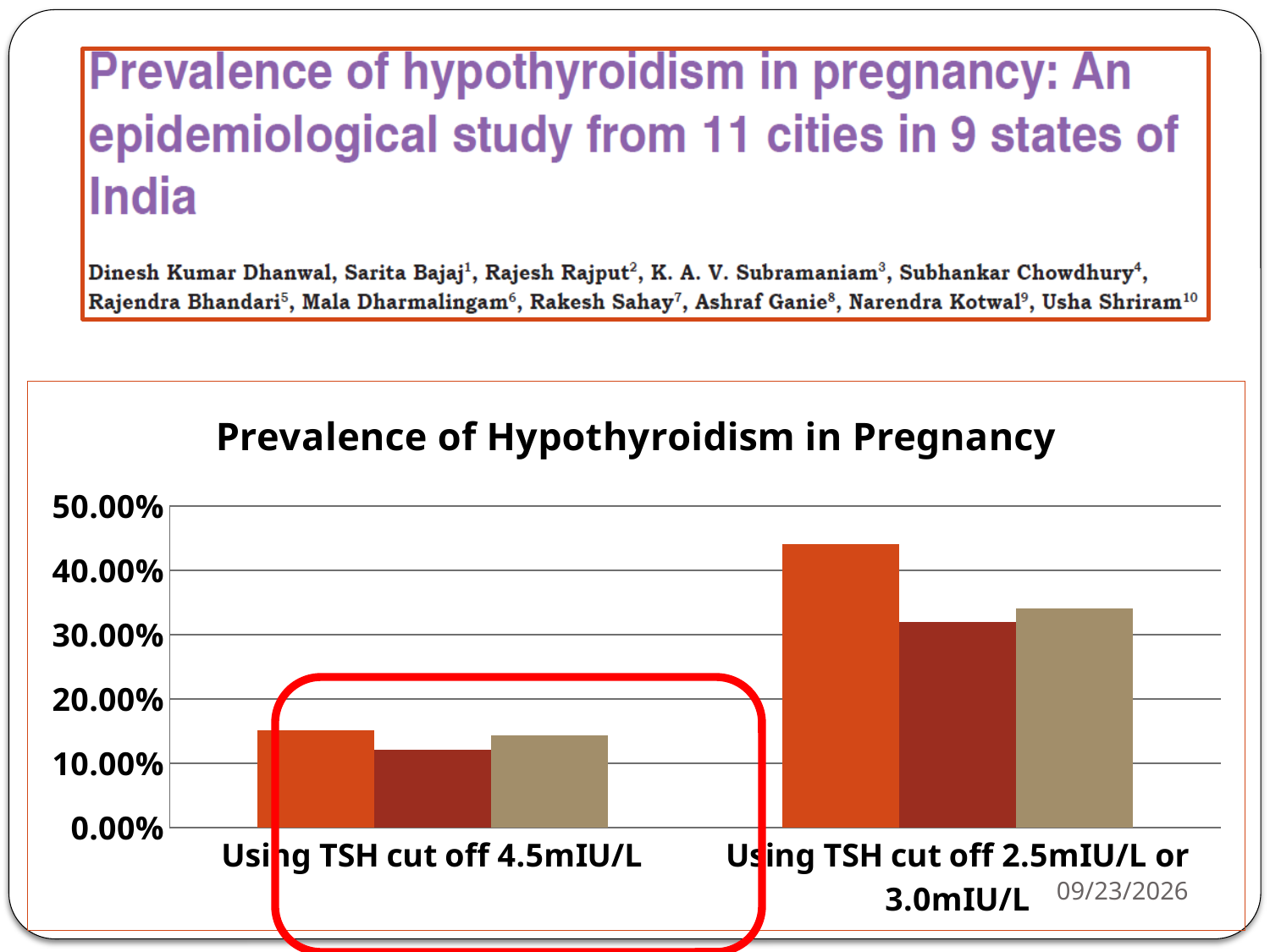
How many bars are plotted for the category "Using TSH cut off 4.5mIU/L"? 3 Which category has the tallest bars in the chart? Using TSH cut off 2.5mIU/L or 3.0mIU/L What type of chart is shown on the slide? bar chart Is the value of the orange bar for "Using TSH cut off 2.5mIU/L or 3.0mIU/L" greater or less than 40.00%? greater What is the highest value shown on the y axis of the chart? 50.00% Is the value of the orange bar for "Using TSH cut off 4.5mIU/L" greater or less than 10.00%? greater Within the category "Using TSH cut off 2.5mIU/L or 3.0mIU/L", which is larger: the orange bar or the dark red bar? the orange bar What is the title of the chart? Prevalence of Hypothyroidism in Pregnancy How many categories are shown on the x axis of the chart? 2 Is the value of the dark red bar for "Using TSH cut off 2.5mIU/L or 3.0mIU/L" greater or less than 40.00%? less